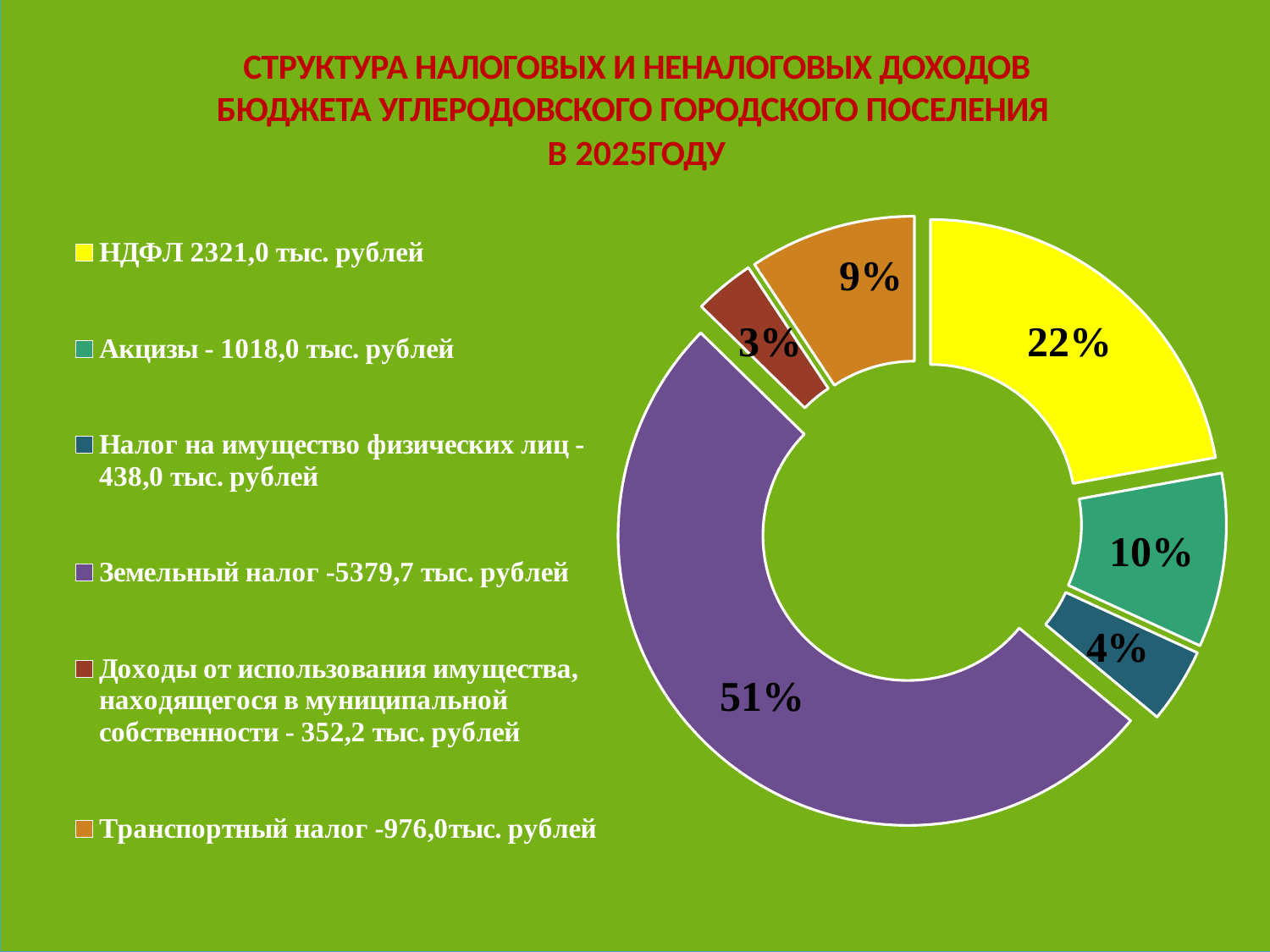
Which category has the largest share of the chart? Земельный налог What share of the chart does Акцизы account for? 10% How many categories does the chart show? 6 According to the legend, what is the amount for Транспортный налог? 976,0 тыс. рублей Which category has the smallest share of the chart? Доходы от использования имущества, находящегося в муниципальной собственности What share of the chart does Транспортный налог account for? 9% What share of the chart does Налог на имущество физических лиц account for? 4% What kind of chart is shown on the slide? Doughnut (pie) chart Which has the larger share: НДФЛ or Акцизы? НДФЛ What is the difference in percentage points between the share of Земельный налог and the share of НДФЛ? 29 percentage points